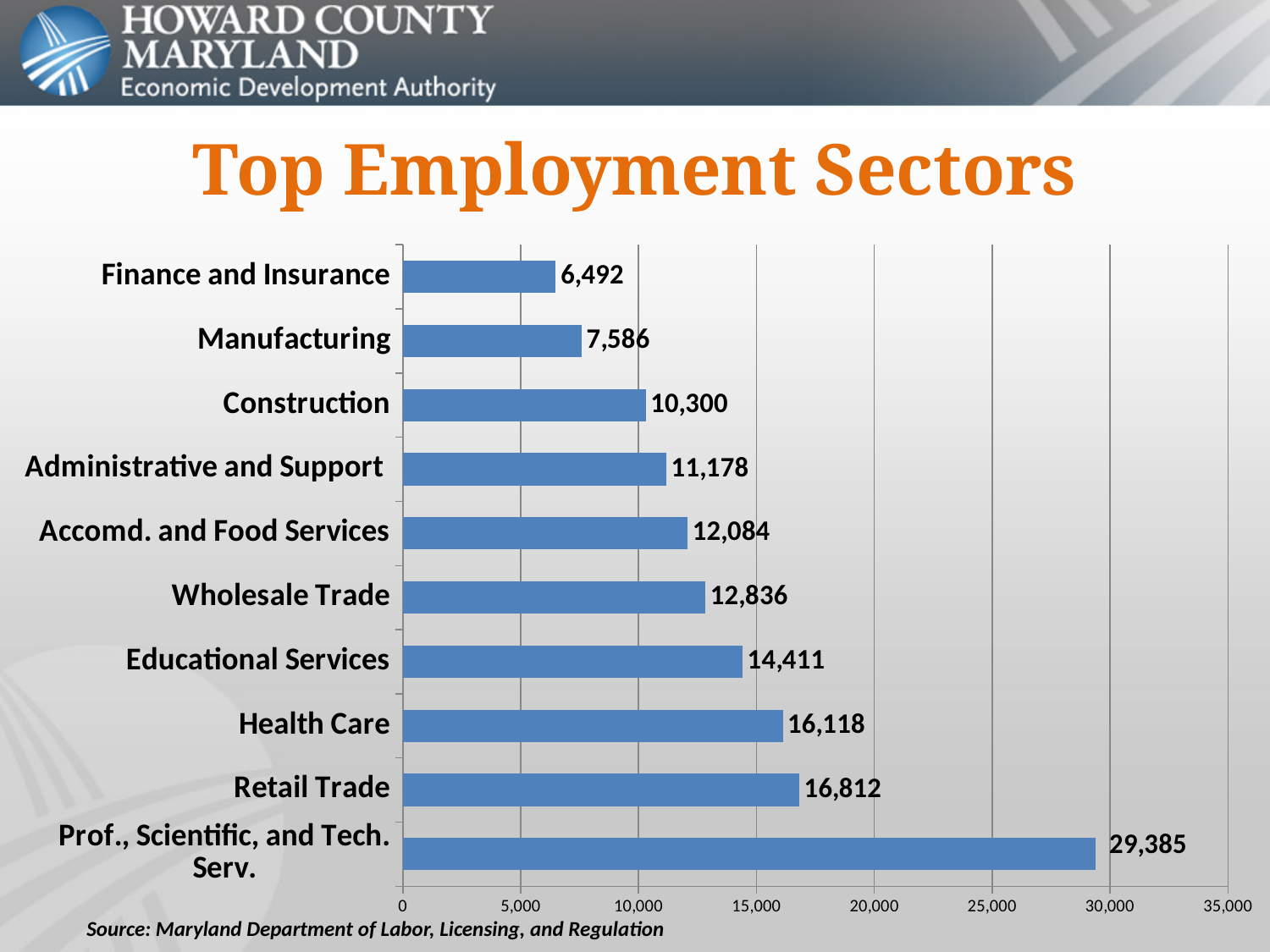
Which sector has the highest value? Prof., Scientific, and Tech. Serv. Is the value for Administrative and Support greater or less than 10,000? greater What is the difference between Prof., Scientific, and Tech. Serv. and Retail Trade? 12,573 What is the value for Health Care? 16,118 Which sector has the lowest value? Finance and Insurance What is the title of the chart? Top Employment Sectors Which is larger, Educational Services or Accomd. and Food Services? Educational Services What is the difference between Retail Trade and Health Care? 694 What kind of chart is shown on the slide? Bar chart What is the value for Wholesale Trade? 12,836 What is the value for Construction? 10,300 How many sectors are shown in the chart? 10